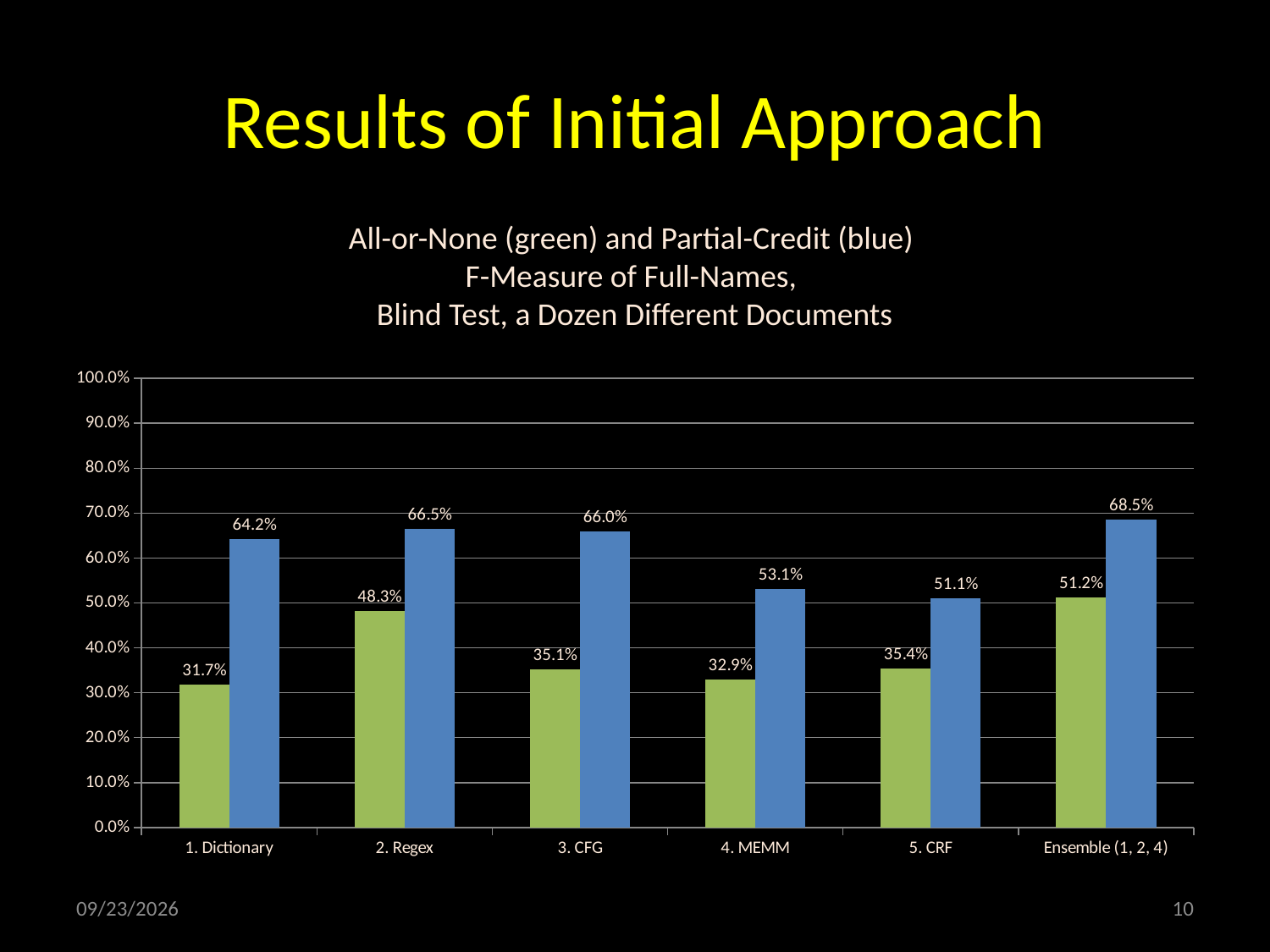
What is the All-or-None (green) F-measure for 2. Regex? 48.3% How many categories are shown on the x axis of the chart? 6 Which category has the lowest All-or-None (green) value? 1. Dictionary Which category has the highest Partial-Credit (blue) value? Ensemble (1, 2, 4) What kind of chart is shown on the slide? Bar chart What is the Partial-Credit (blue) F-measure for 4. MEMM? 53.1% What is the difference between the Partial-Credit (blue) and All-or-None (green) values for Ensemble (1, 2, 4)? 17.3 percentage points Is the Partial-Credit (blue) value for 1. Dictionary greater or less than 60.0%? greater According to the chart subtitle, which colour represents the Partial-Credit F-measure? Blue What is the All-or-None (green) F-measure for 5. CRF? 35.4% Which has the larger All-or-None (green) value, 4. MEMM or 5. CRF? 5. CRF What is the difference between the Partial-Credit (blue) and All-or-None (green) values for 1. Dictionary? 32.5 percentage points